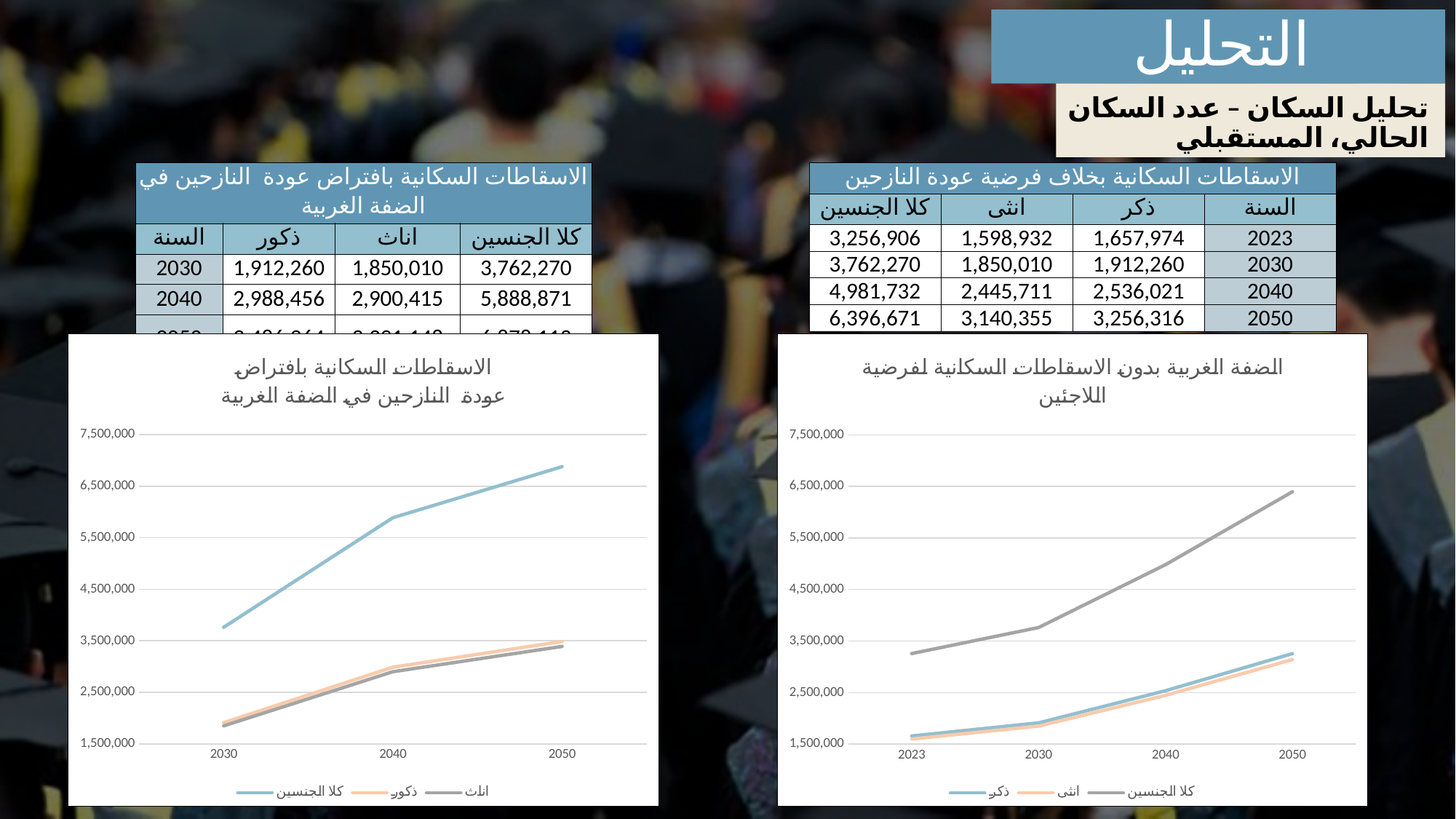
In the left chart 'الاسقاطات السكانية بافتراض عودة النازحين في الضفة الغربية', is the value of كلا الجنسين in 2050 greater or less than 6,500,000? greater In the right chart 'الضفة الغربية بدون الاسقاطات السكانية لفرضية اللاجئين', is the value of كلا الجنسين in 2023 greater or less than 3,500,000? less In the right chart 'الضفة الغربية بدون الاسقاطات السكانية لفرضية اللاجئين', which year has the highest value for كلا الجنسين? 2050 How many years are plotted on the x axis of the right chart 'الضفة الغربية بدون الاسقاطات السكانية لفرضية اللاجئين'? 4 In the right chart 'الضفة الغربية بدون الاسقاطات السكانية لفرضية اللاجئين', is the value of كلا الجنسين in 2050 greater or less than 6,500,000? less In the left chart 'الاسقاطات السكانية بافتراض عودة النازحين في الضفة الغربية', does the كلا الجنسين line rise or fall from 2030 to 2050? Rises Which is larger in 2050: كلا الجنسين in the left chart 'الاسقاطات السكانية بافتراض عودة النازحين في الضفة الغربية' or كلا الجنسين in the right chart 'الضفة الغربية بدون الاسقاطات السكانية لفرضية اللاجئين'? The left chart In the right chart 'الضفة الغربية بدون الاسقاطات السكانية لفرضية اللاجئين', which series is drawn in gray? كلا الجنسين What type of chart is the left chart titled 'الاسقاطات السكانية بافتراض عودة النازحين في الضفة الغربية'? Line chart How many series does the legend of the right chart 'الضفة الغربية بدون الاسقاطات السكانية لفرضية اللاجئين' list? 3 How many years are plotted on the x axis of the left chart 'الاسقاطات السكانية بافتراض عودة النازحين في الضفة الغربية'? 3